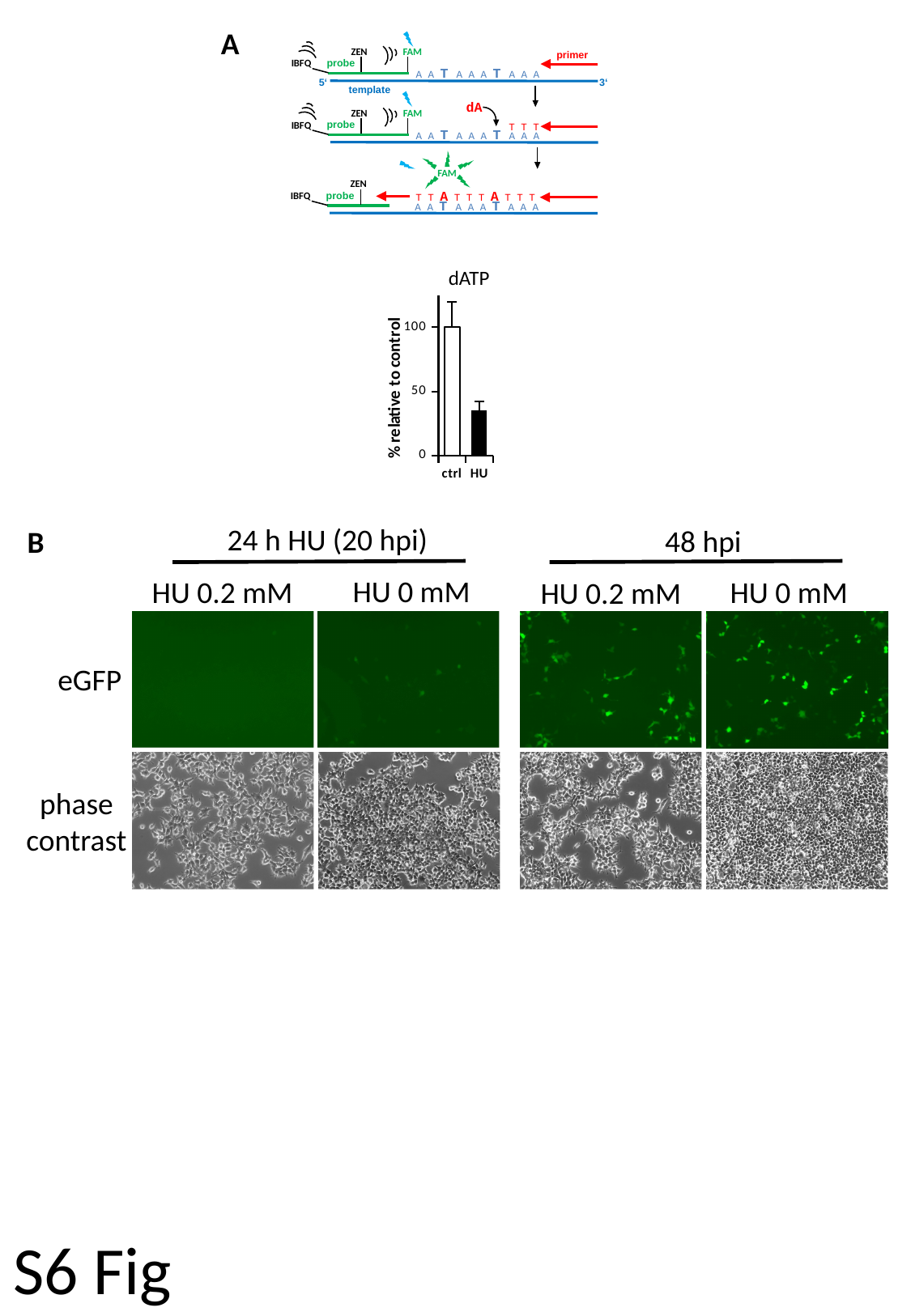
What is the value for ctrl in the dATP chart? 100 In the dATP chart, which is larger, the value for ctrl or the value for HU? ctrl Which category has the highest value in the dATP chart? ctrl What is the y-axis label of the dATP chart? % relative to control Which category has the lowest value in the dATP chart? HU In the dATP chart, is the value for HU greater or less than 50? less What is the title of the bar chart on the slide? dATP What kind of chart is the dATP chart? bar chart How many categories are shown on the x axis of the dATP chart? 2 In the dATP chart, is the value for ctrl greater or less than 50? greater Do the values in the dATP chart rise or fall from ctrl to HU? fall